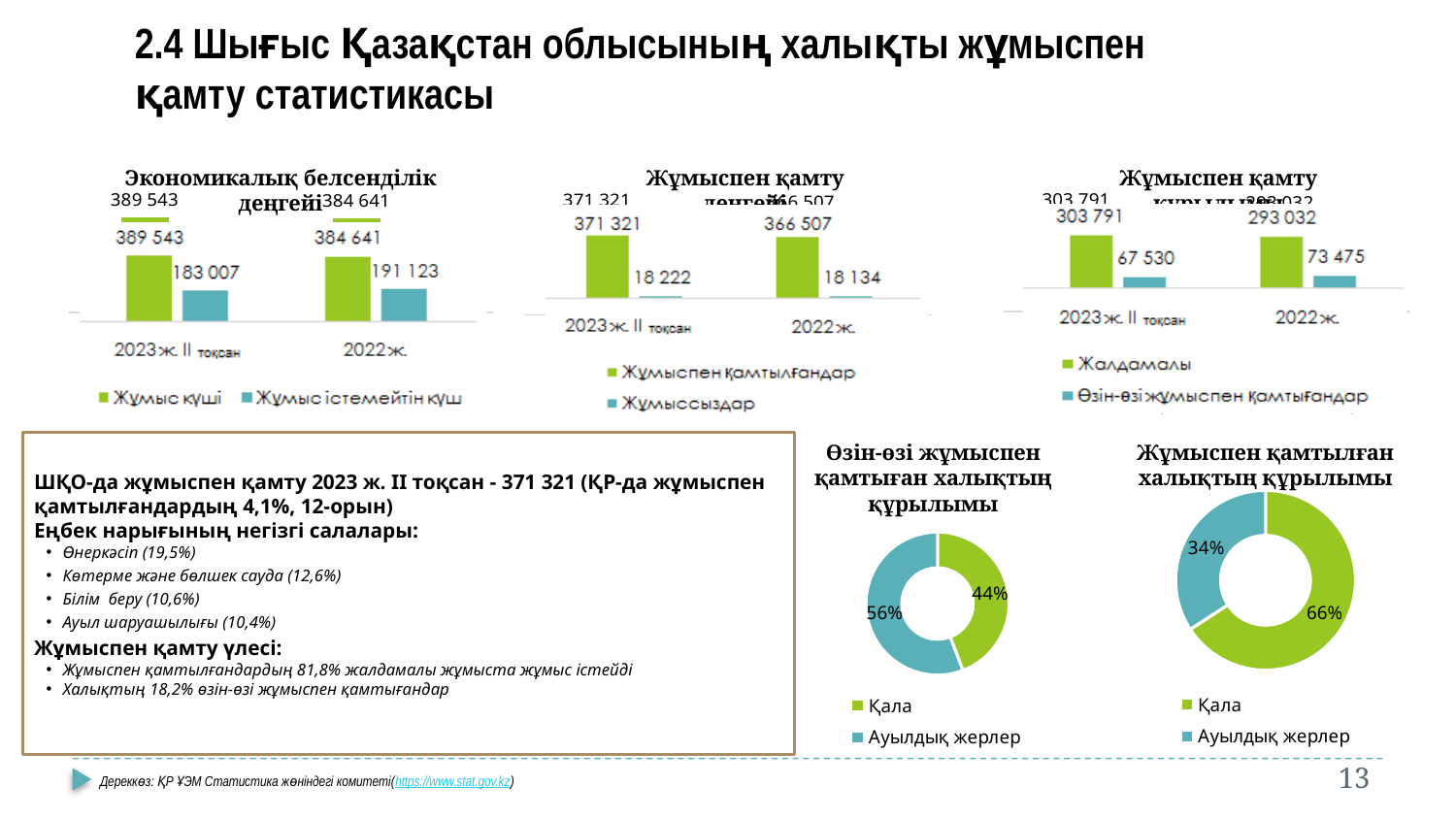
In the chart titled 'Жұмыспен қамтылған халықтың құрылымы', what share does 'Қала' have? 66% In the chart titled 'Жұмыспен қамту құрылымы', what is the value of 'Жалдамалы' for 2022 ж.? 293 032 In the chart titled 'Жұмыспен қамту деңгейі', what is the value of 'Жұмыспен қамтылғандар' for 2023 ж. II тоқсан? 371 321 In the chart titled 'Жұмыспен қамту құрылымы', what is the value of 'Өзін-өзі жұмыспен қамтығандар' for 2023 ж. II тоқсан? 67 530 In the chart titled 'Жұмыспен қамту құрылымы', how many series does the legend list? 2 In the chart titled 'Жұмыспен қамту деңгейі', which is larger: 'Жұмыссыздар' for 2023 ж. II тоқсан or for 2022 ж.? 2023 ж. II тоқсан In the chart titled 'Экономикалық белсенділік деңгейі', what is the difference between the 'Жұмыс күші' values for 2023 ж. II тоқсан and 2022 ж.? 4 902 In the chart titled 'Өзін-өзі жұмыспен қамтыған халықтың құрылымы', what share does 'Ауылдық жерлер' have? 56% In the chart titled 'Жұмыспен қамту деңгейі', what is the value of 'Жұмыссыздар' for 2022 ж.? 18 134 What kind of chart is the one titled 'Жұмыспен қамтылған халықтың құрылымы'? Doughnut chart In the chart titled 'Экономикалық белсенділік деңгейі', what is the value of 'Жұмыс істемейтін күш' for 2022 ж.? 191 123 In the chart titled 'Экономикалық белсенділік деңгейі', what is the value of 'Жұмыс күші' for 2023 ж. II тоқсан? 389 543